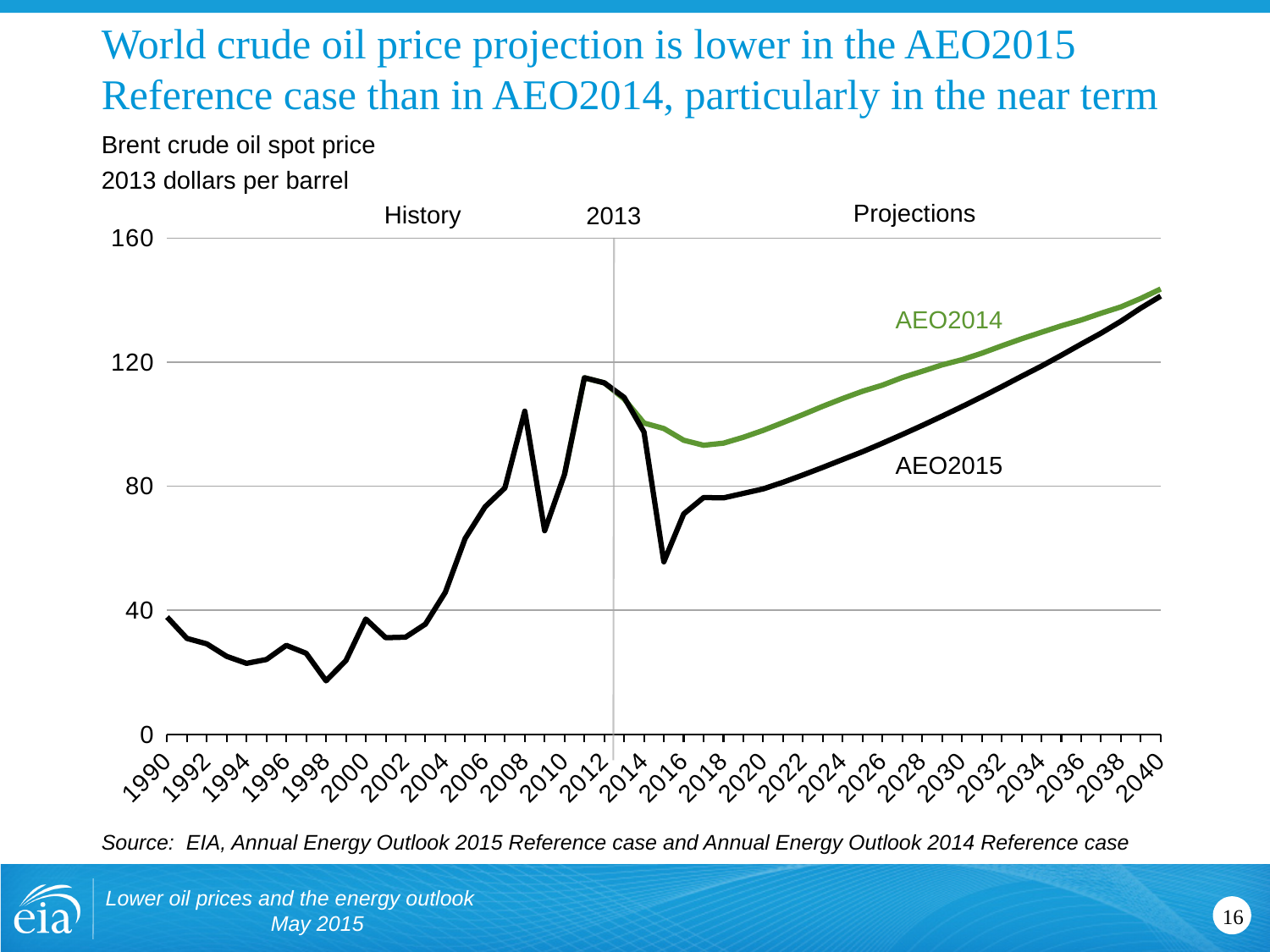
What unit is the Brent crude oil spot price plotted in? 2013 dollars per barrel Is the AEO2015 value for 2040 greater or less than 120? greater Does the AEO2015 series rise or fall between 2020 and 2040? rise Is the historical value for 2008 greater or less than 80? greater In 2020, which series shows the higher price, AEO2014 or AEO2015? AEO2014 In 2030, which series shows the higher price, AEO2014 or AEO2015? AEO2014 Which two series are labeled on the chart? AEO2014 and AEO2015 Is the AEO2014 value for 2018 greater or less than 80? greater How many projection series are labeled on the chart? 2 What kind of chart is shown on the slide? line chart